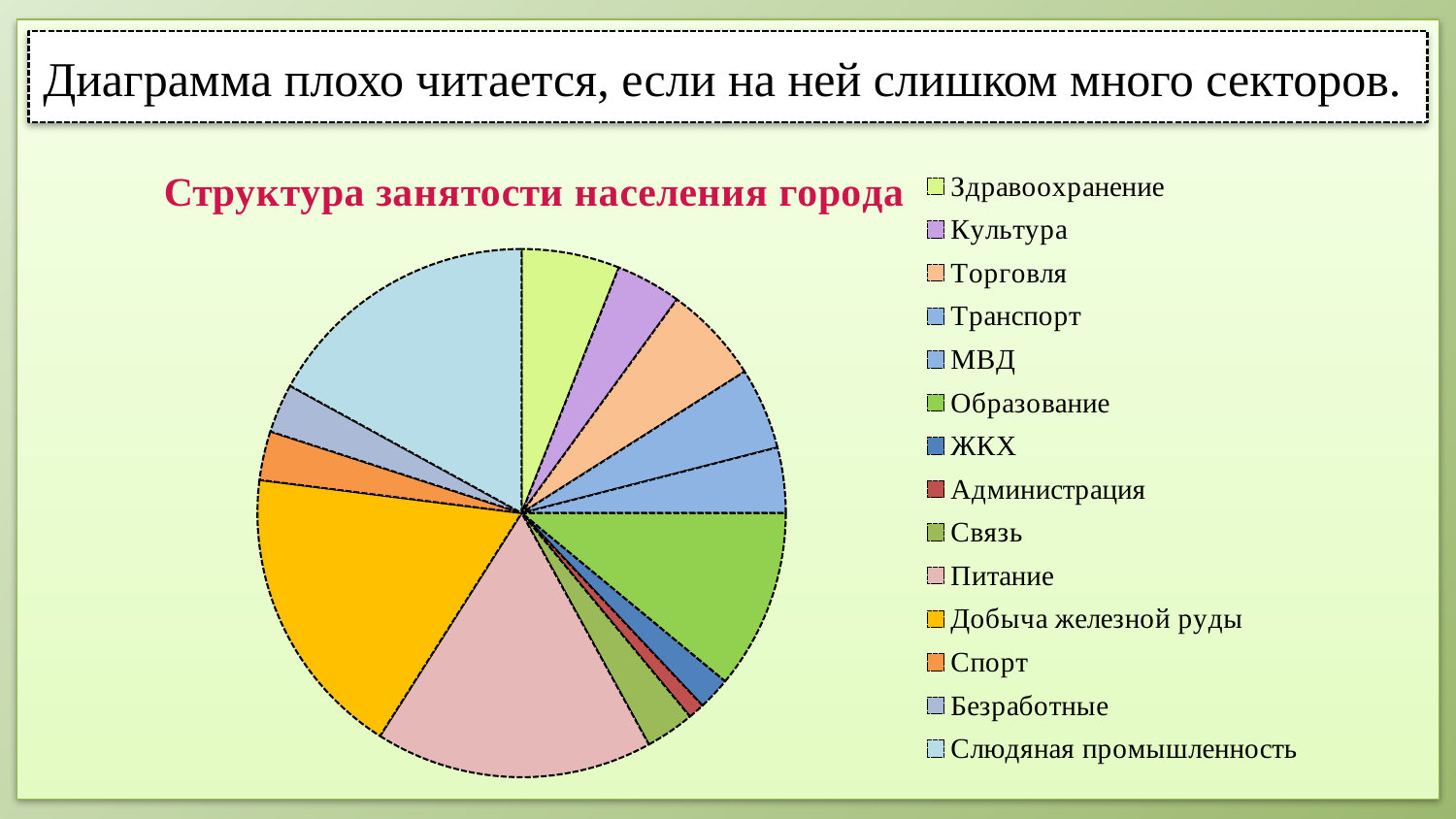
Which sector is larger: Слюдяная промышленность or Спорт? Слюдяная промышленность Which sector is larger: Питание or Связь? Питание How many entries does the legend list? 14 What is the title of the chart? Структура занятости населения города How many categories (sectors) does the pie chart have? 14 Which sector is larger: Добыча железной руды or Безработные? Добыча железной руды What type of chart is shown on the slide? Pie chart What colour is the sector for Добыча железной руды? Yellow Which category has the smallest sector in the pie chart? Администрация